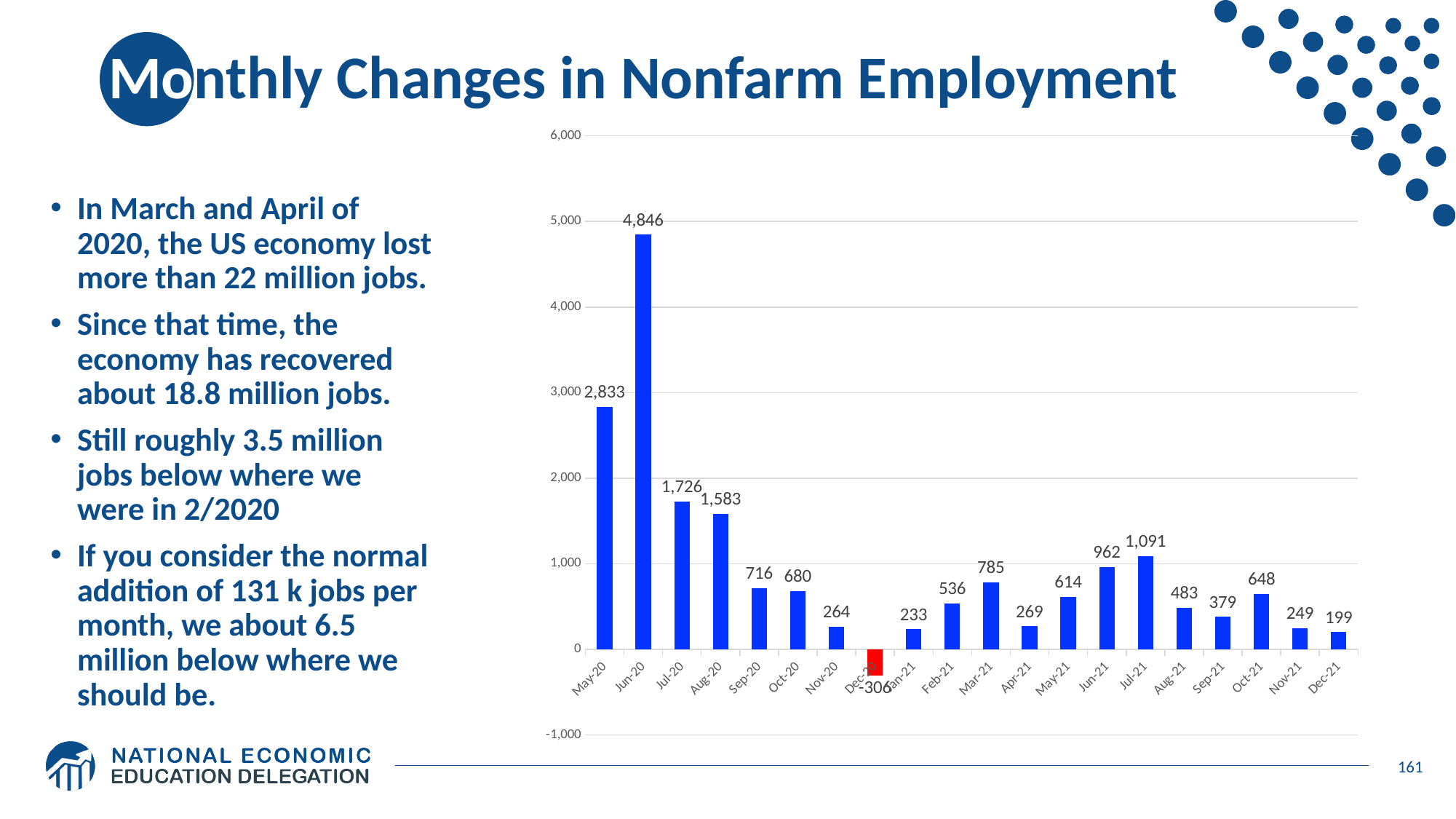
Which is larger, the value for Mar-21 or the value for Feb-21? Mar-21 What is the value for May-20? 2,833 What kind of chart is shown on the slide? Bar chart What is the value for Jun-20? 4,846 What is the value for Dec-21? 199 What is the difference between the values for Jun-20 and May-20? 2,013 Which month's bar is coloured red instead of blue? Dec-20 Which month has the highest value? Jun-20 Which month has the lowest value? Dec-20 How many months are plotted on the chart? 20 What is the value for Jul-21? 1,091 Is the value for Aug-20 greater or less than 2,000? less